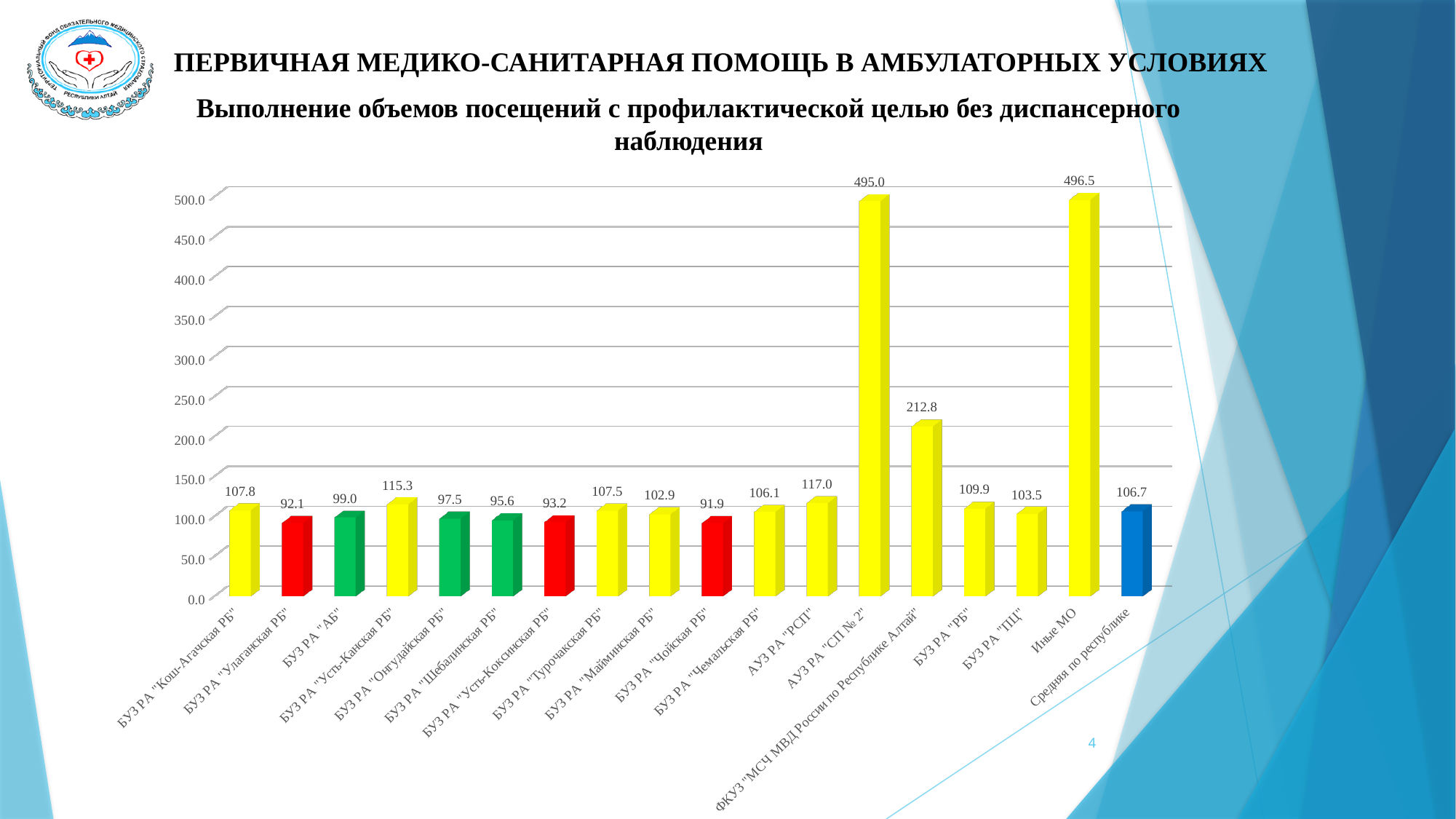
What is the value for БУЗ РА "Усть-Канская РБ"? 115.3 What colour is the bar for Средняя по республике? Blue What kind of chart is shown on the slide? Bar chart What is the value for ФКУЗ "МСЧ МВД России по Республике Алтай"? 212.8 Which category has the lowest value? БУЗ РА "Чойская РБ" What is the difference between the values for Иные МО and АУЗ РА "СП № 2"? 1.5 What is the difference between the values for АУЗ РА "РСП" and Средняя по республике? 10.3 What is the value for Средняя по республике? 106.7 What is the value for БУЗ РА "Чойская РБ"? 91.9 How many categories are shown on the x axis? 18 Which category has the highest value? Иные МО Which is larger, the value for БУЗ РА "Кош-Агачская РБ" or БУЗ РА "Турочакская РБ"? БУЗ РА "Кош-Агачская РБ"